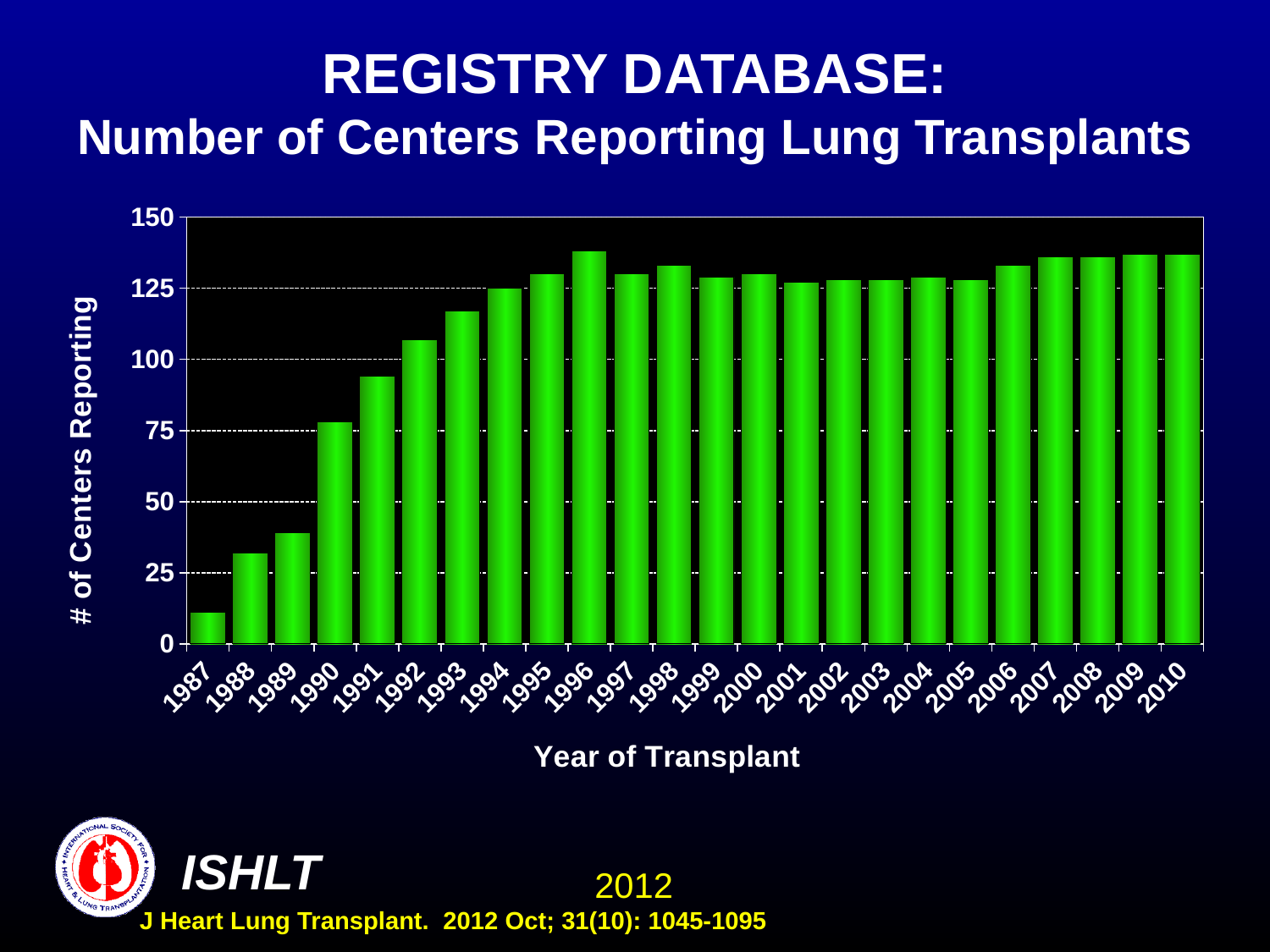
Is the value for 1996 greater or less than 125? greater What is the title of the y axis? # of Centers Reporting Which year has the larger number of centers reporting, 1989 or 1990? 1990 Overall, do the values rise or fall from 1987 to 2010? rise Is the value for 1991 greater or less than 100? less Is the value for 1989 greater or less than 50? less Which year has the lowest number of centers reporting? 1987 What kind of chart is shown on the slide? bar chart How many years are shown on the x axis of the chart? 24